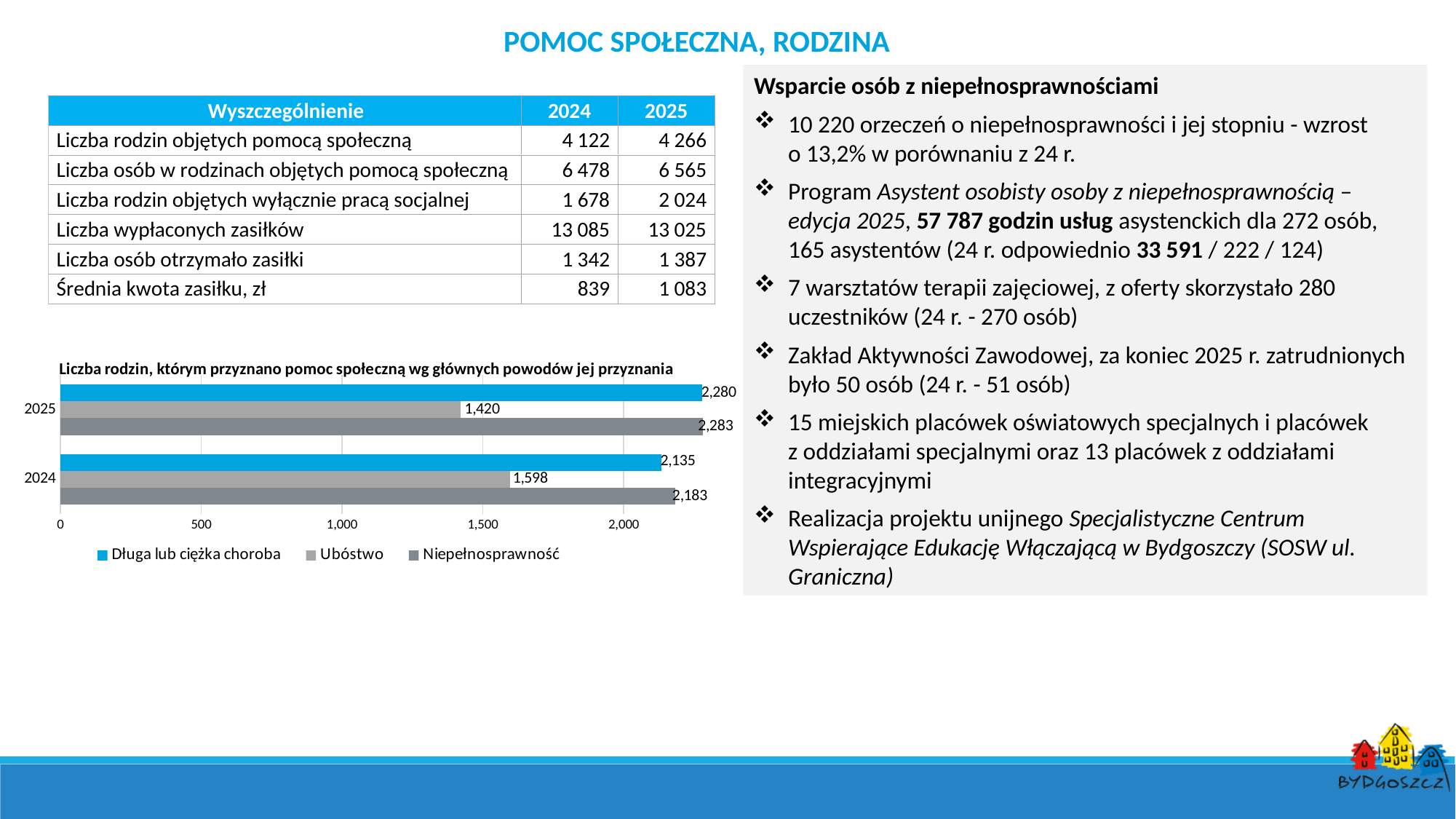
What is the value for Długa lub ciężka choroba in 2024? 2,135 What is the value for Niepełnosprawność in 2025? 2,283 How many series does the legend list? 3 What is the difference between the Niepełnosprawność values for 2025 and 2024? 100 What is the value for Ubóstwo in 2024? 1,598 What kind of chart is shown on the slide? bar chart Which reason has the lowest value in 2024? Ubóstwo Which colour represents Długa lub ciężka choroba in the chart? blue Is the value for Długa lub ciężka choroba in 2025 larger or smaller than the value for Ubóstwo in 2025? larger What is the value for Ubóstwo in 2025? 1,420 Which reason has the lowest value in 2025? Ubóstwo What is the difference between the Ubóstwo values for 2024 and 2025? 178